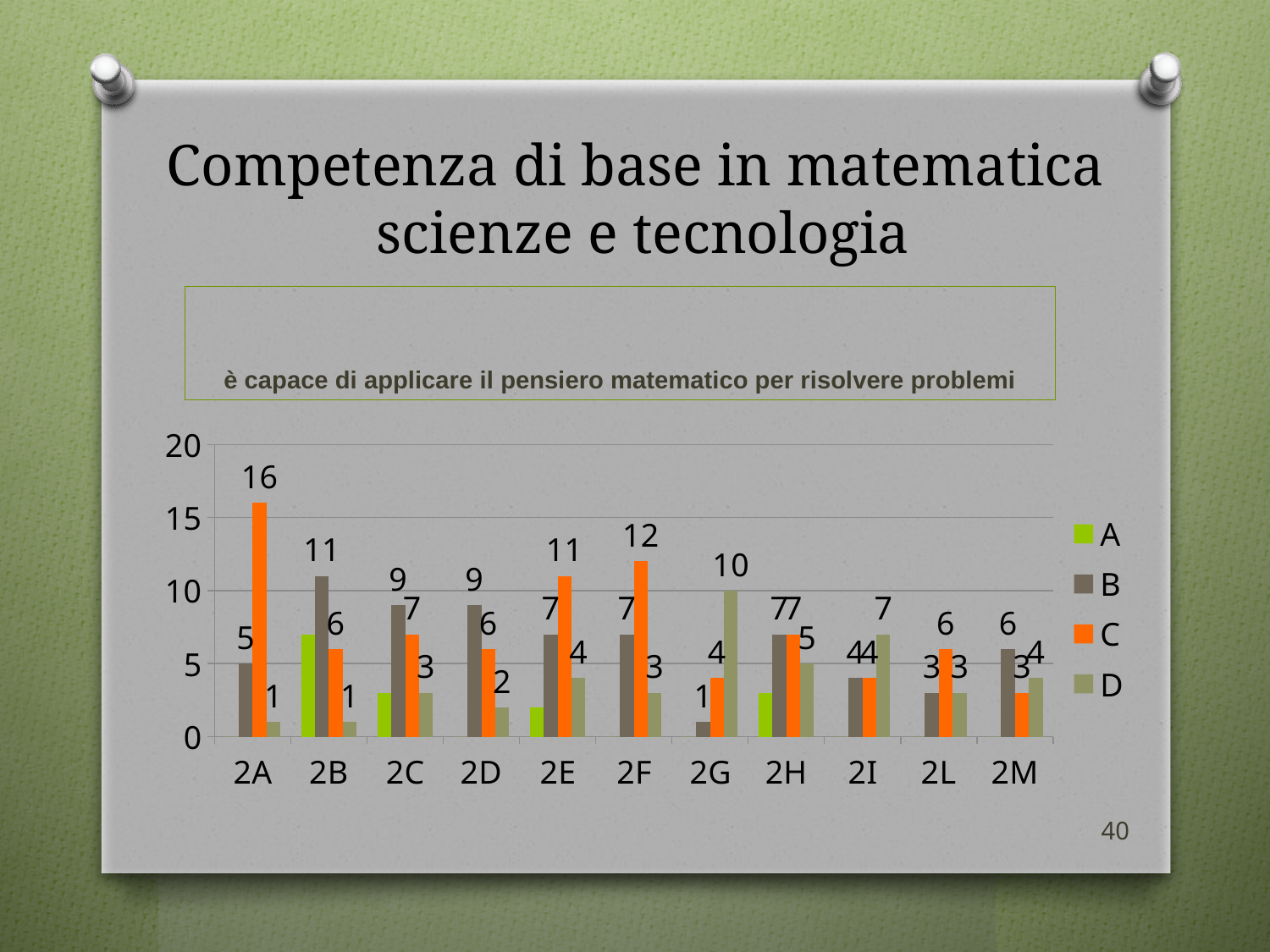
How many categories are shown on the x axis? 11 Which category has the highest value for series C? 2A For 2G, which is larger: series D or series C? D What is the value of series B for 2B? 11 What is the value of series C for 2A? 16 How many series does the legend list? 4 Is the value of series A for 2B greater or less than 5? greater What is the value of series D for 2G? 10 Which category has the lowest value for series B? 2G What is the difference between series C and series B for 2A? 11 What is the value of series C for 2F? 12 What kind of chart is shown on the slide? bar chart